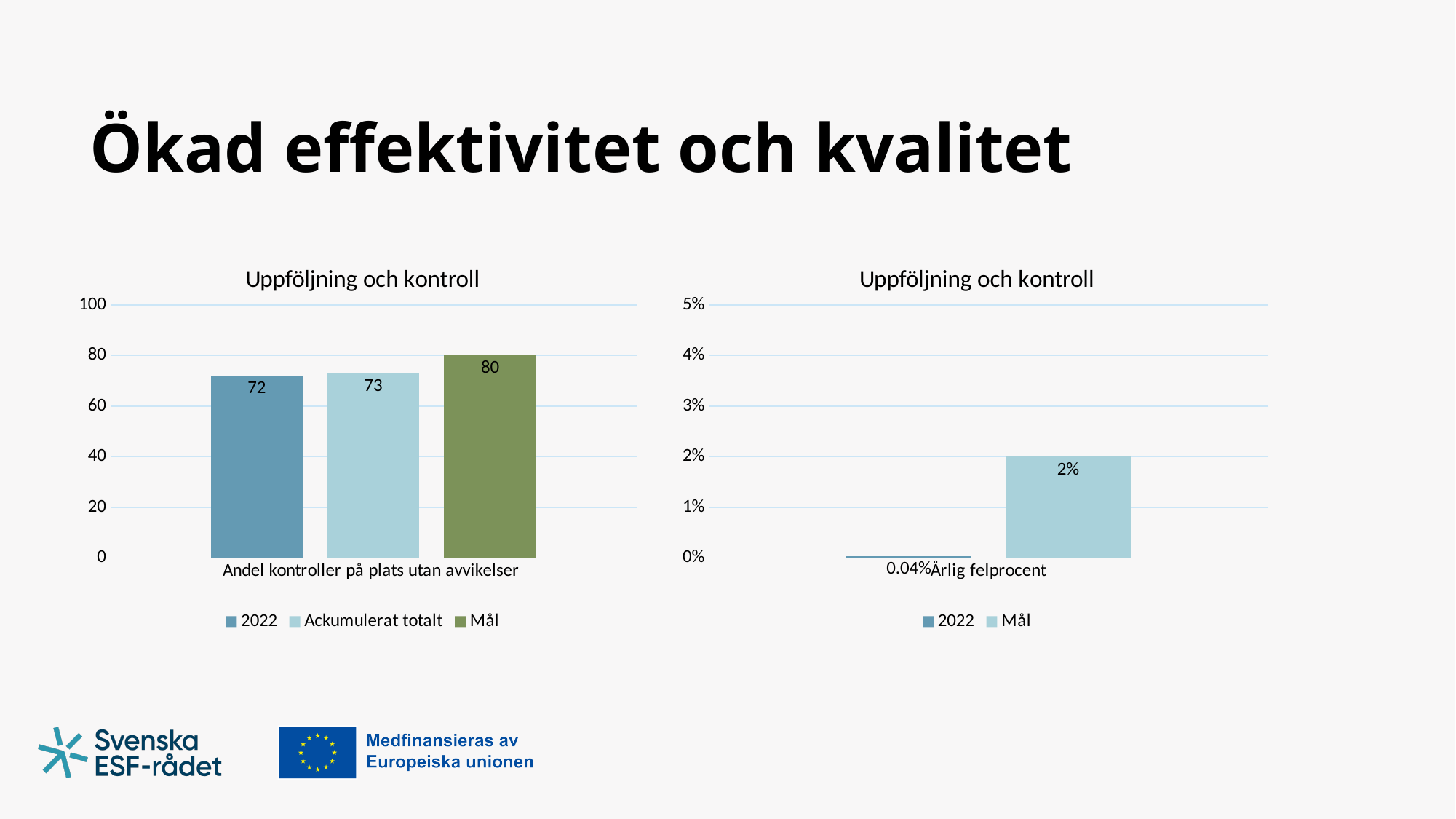
In the left chart, what is the difference between the Mål value and the 2022 value? 8 In the left chart, what is the value for Ackumulerat totalt? 73 What is the category label on the x axis of the left chart? Andel kontroller på plats utan avvikelser In the left chart, what is the value for Mål? 80 In the right chart, what is the value for 2022? 0.04% In the right chart, is the value for Mål greater or less than 3%? less In the right chart, which series has the lower value, 2022 or Mål? 2022 In the left chart, which series has the highest value? Mål In the right chart, what is the value for Mål? 2% In the left chart, what is the value for the 2022 series? 72 In the left chart, how many series does the legend list? 3 What kind of chart is the right chart? Bar chart